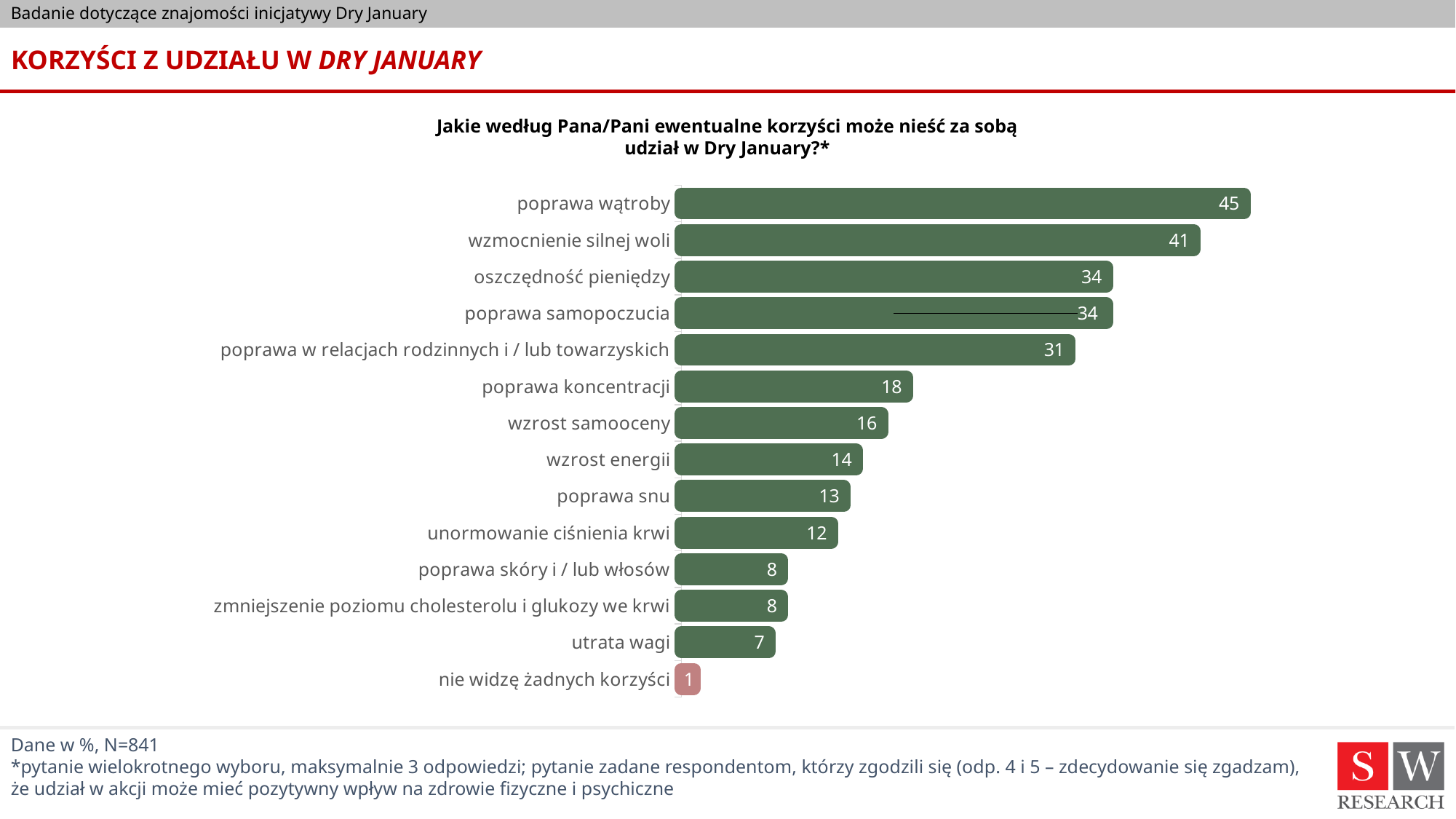
What is the difference between the values for "poprawa koncentracji" and "poprawa snu"? 5 What is the value for "utrata wagi"? 7 Which category has the highest value? poprawa wątroby What is the value for "poprawa wątroby"? 45 What is the value for "wzrost samooceny"? 16 Which is larger, the value for "poprawa w relacjach rodzinnych i / lub towarzyskich" or the value for "wzrost energii"? poprawa w relacjach rodzinnych i / lub towarzyskich What is the value for "unormowanie ciśnienia krwi"? 12 Which category's bar is shown in a different colour (red) from the others? nie widzę żadnych korzyści What kind of chart is shown on the slide? bar chart Which category has the lowest value? nie widzę żadnych korzyści What is the difference between the values for "poprawa wątroby" and "wzmocnienie silnej woli"? 4 How many categories are shown in the chart? 14